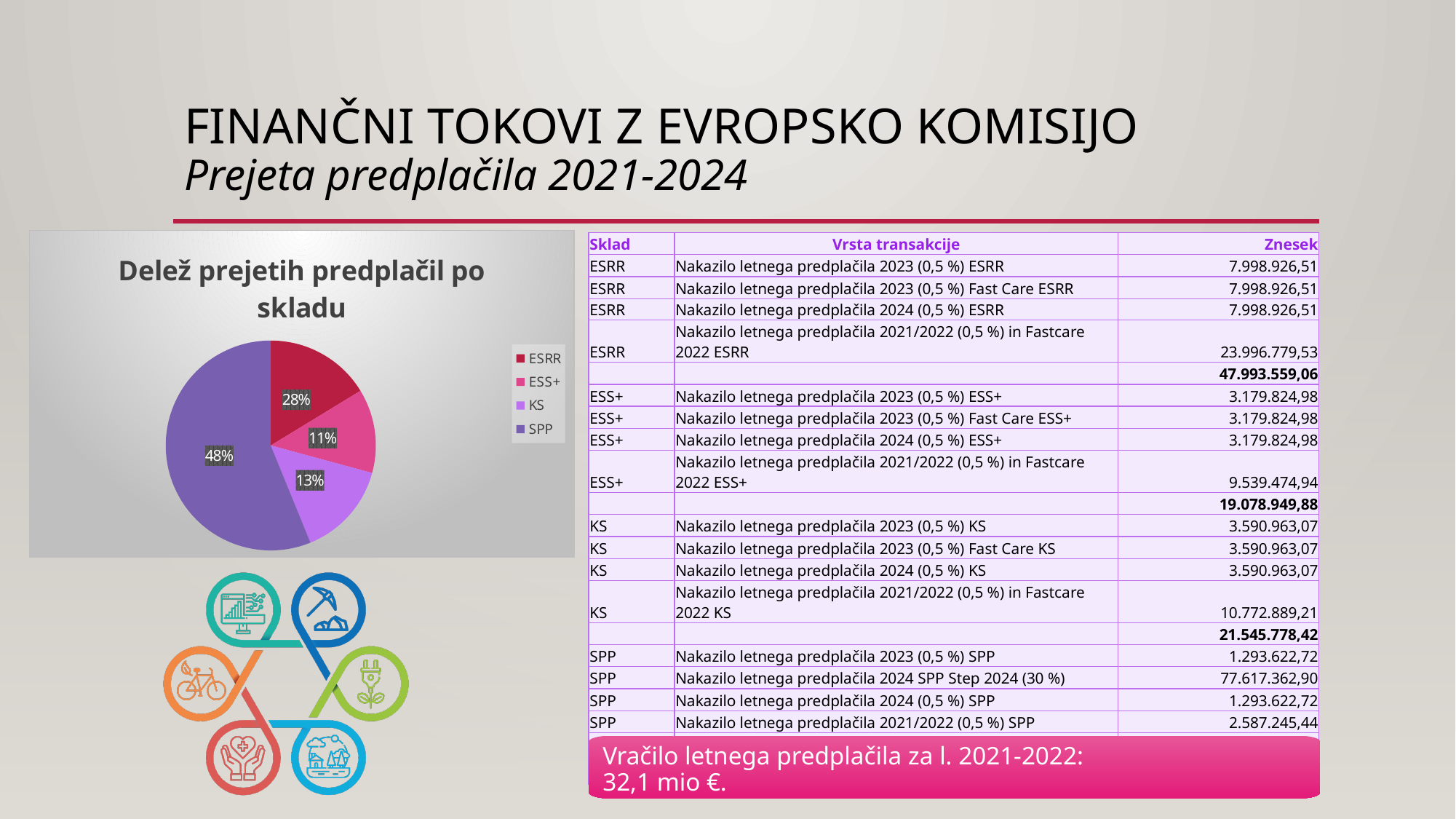
What share of the pie does ESRR have? 28% What is the difference in percentage points between the SPP slice and the ESRR slice? 20 Which fund has the largest slice of the pie? SPP What share of the pie does SPP have? 48% Which slice is larger, KS or ESS+? KS What share of the pie does KS have? 13% Which fund has the smallest slice of the pie? ESS+ What kind of chart is shown on the slide? pie chart What is the title of the pie chart? Delež prejetih predplačil po skladu How many entries does the legend of the pie chart list? 4 How many slices does the pie chart have? 4 What share of the pie does ESS+ have? 11%